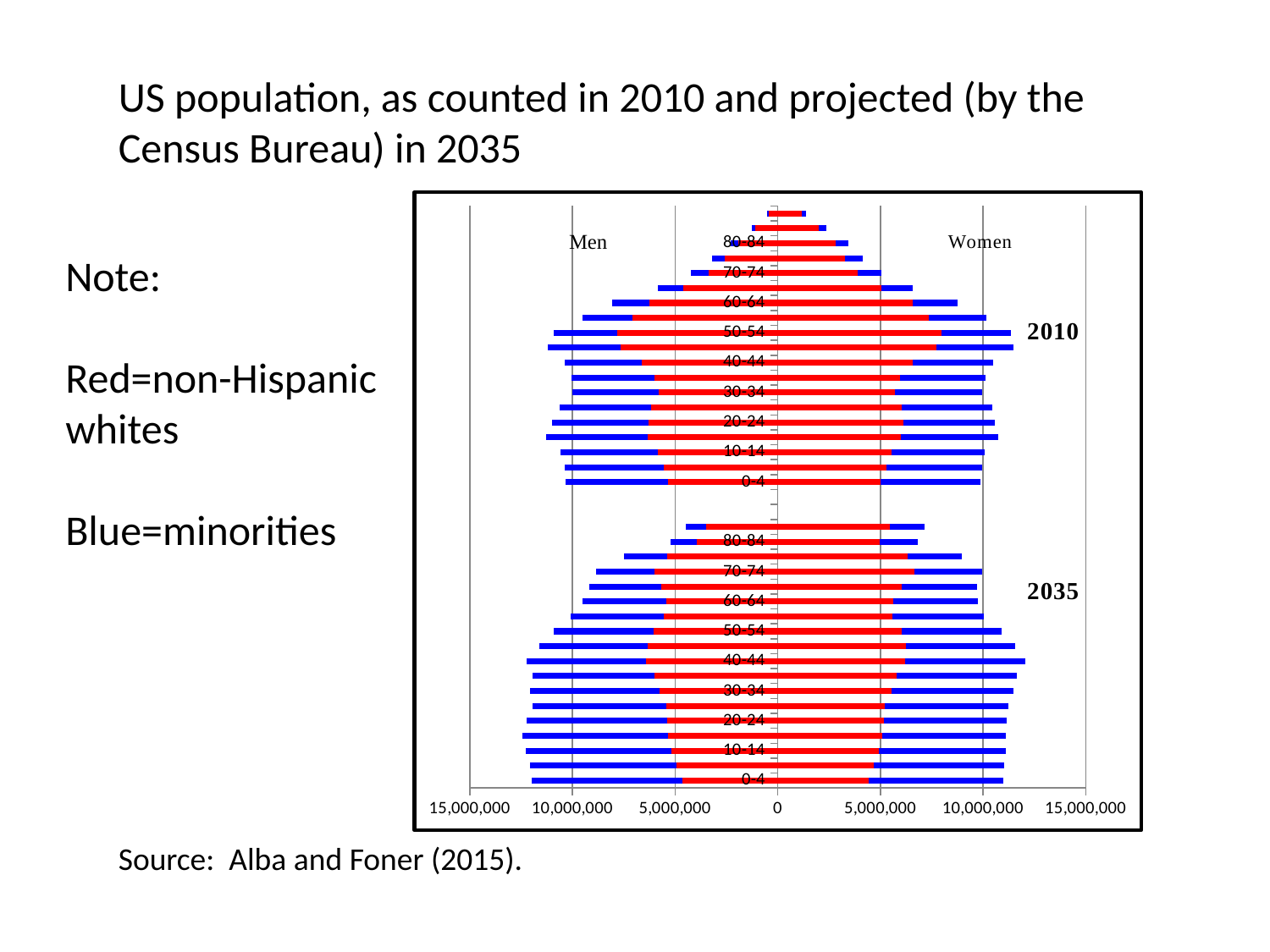
In the 2035 panel, is the total bar for men aged 40-44 greater or less than 10,000,000? greater According to the note on the slide, what do the red portions of the bars represent? non-Hispanic whites In the 2035 panel, is the total bar for women aged 80-84 greater or less than 5,000,000? greater How many age-group labels are printed on the 2010 panel of the chart? 9 In the 2035 panel, do the bars for women get shorter or longer going from the 40-44 age group up to the 80-84 age group? shorter What kind of chart is shown on the slide? bar chart In the 2010 panel, is the total bar for women aged 50-54 greater or less than 10,000,000? greater What is the largest value labeled on the horizontal axis? 15,000,000 Which is larger: the total bar for women aged 80-84 in 2010 or in 2035? 2035 Which side of the chart shows men, the left or the right? left